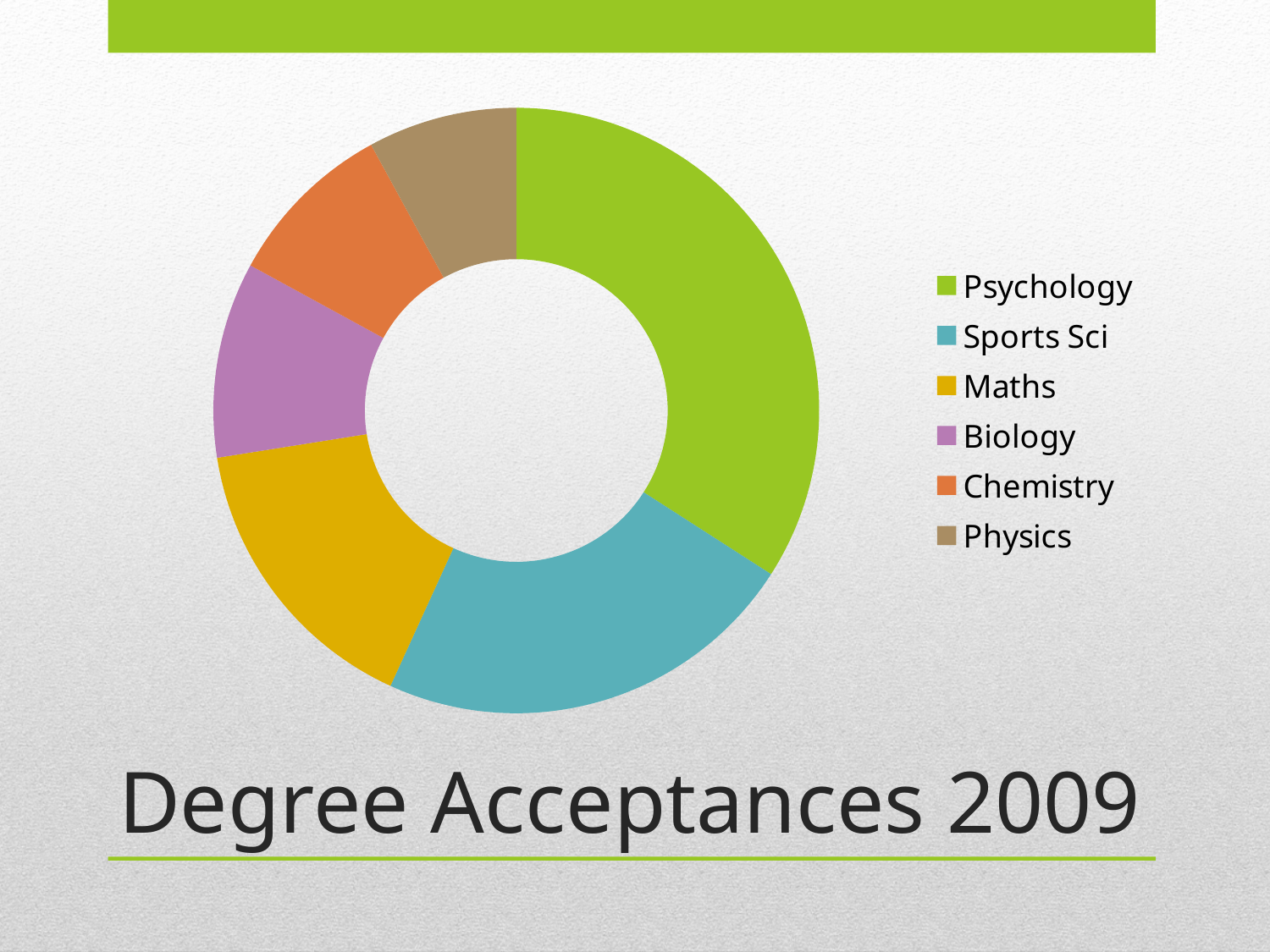
Which category has the second-largest share of the chart? Sports Sci How many categories does the chart's legend list? 6 Which is larger, the share for Psychology or the share for Sports Sci? Psychology What is the title shown on the slide for this chart? Degree Acceptances 2009 Which is larger, the share for Maths or the share for Biology? Maths Which category has the largest share of the chart? Psychology Which category is shown in green in the chart? Psychology What kind of chart is shown on the slide? Doughnut chart Which is larger, the share for Sports Sci or the share for Maths? Sports Sci